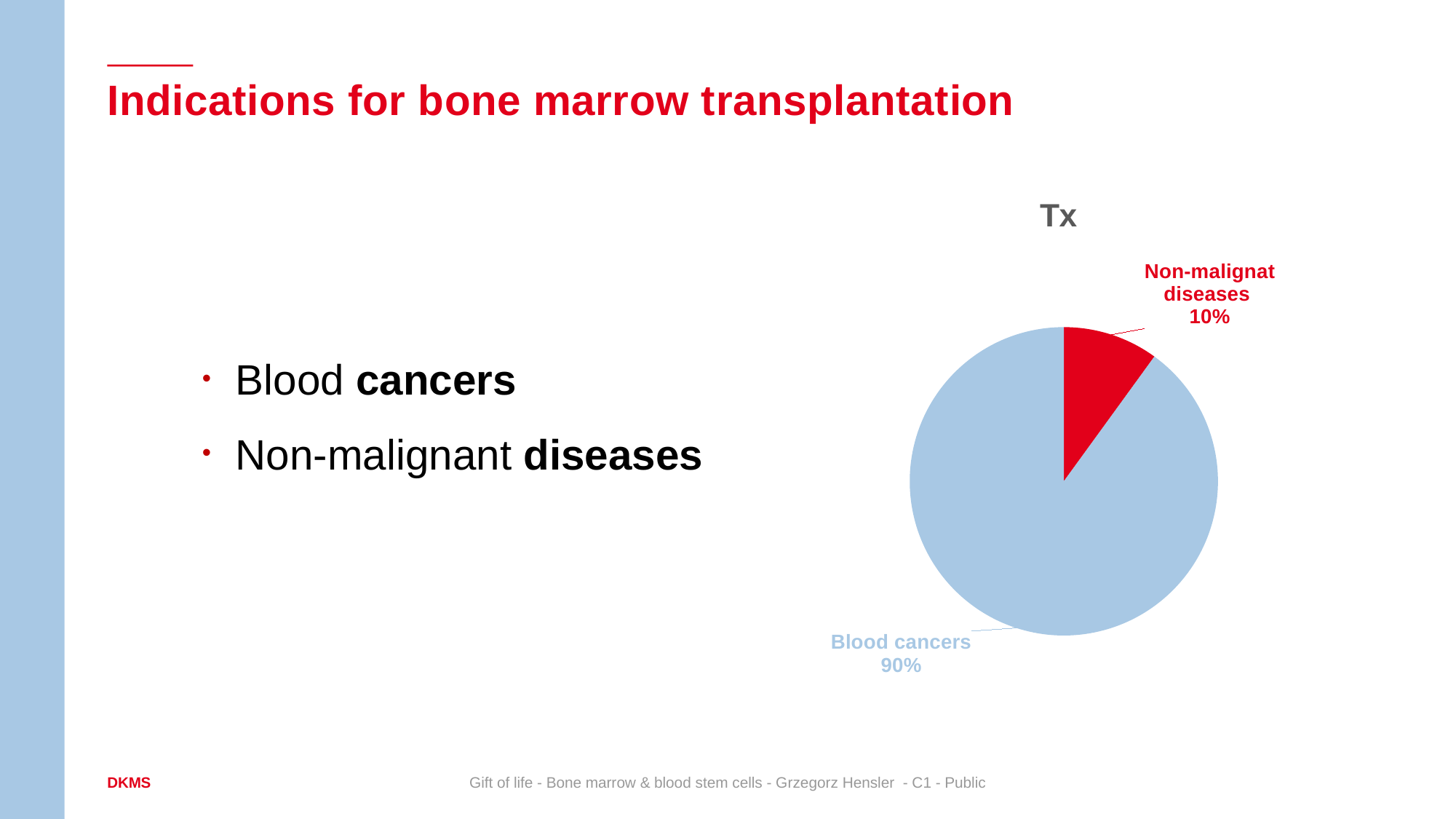
Which is larger, the Blood cancers slice or the Non-malignat diseases slice? Blood cancers How many slices does the pie chart have? 2 What share of the pie is Blood cancers? 90% What share of the pie is Non-malignat diseases? 10% What type of chart is shown on the slide? pie chart Which slice of the pie is the largest? Blood cancers What is the difference in percentage points between Blood cancers and Non-malignat diseases? 80 Which slice of the pie is the smallest? Non-malignat diseases What is the title of the chart? Tx What is the total of the two slices shown in the pie chart? 100% What colour is the Non-malignat diseases slice? red